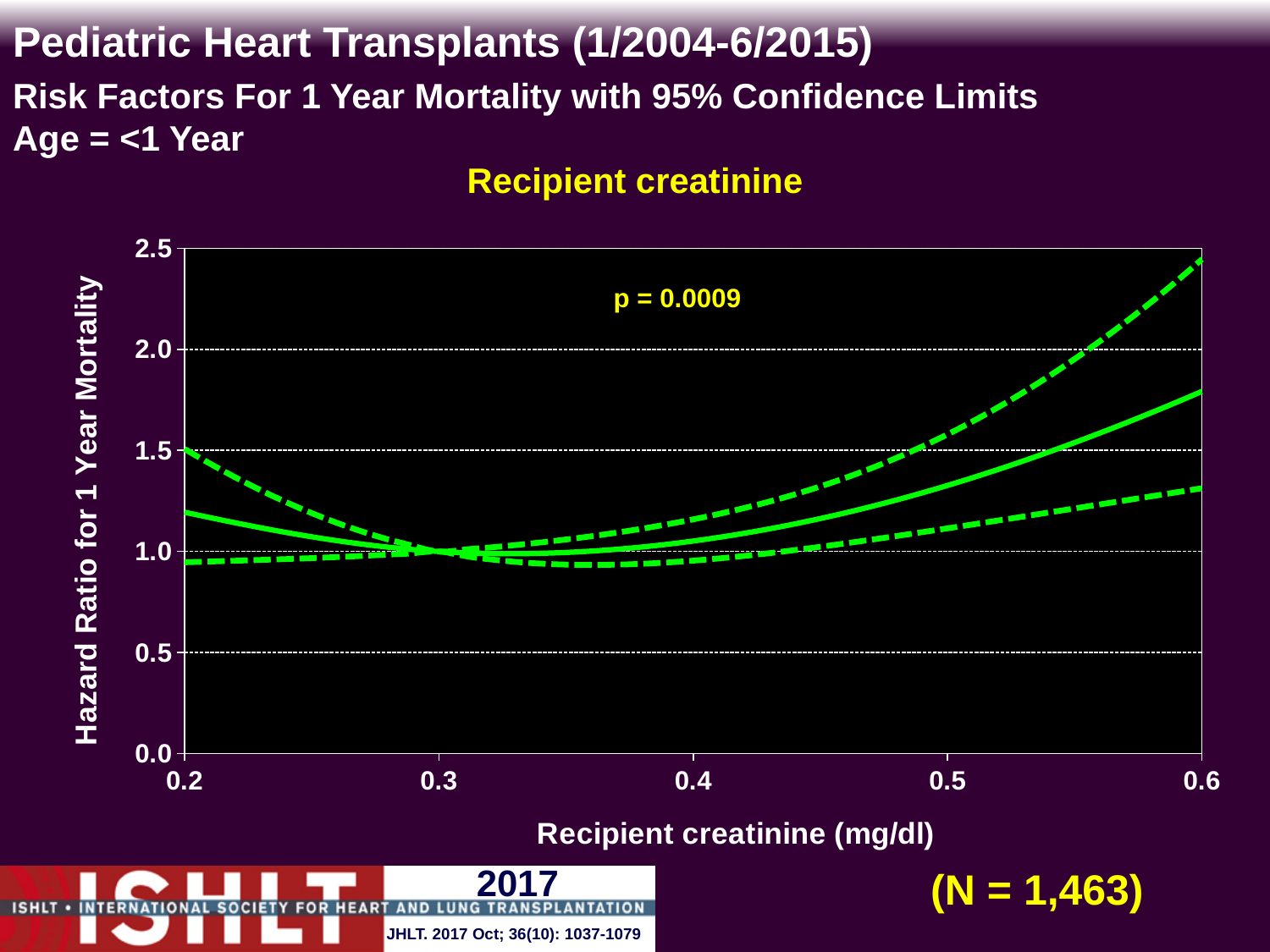
Is the solid hazard ratio line at a recipient creatinine of 0.6 mg/dl greater or less than 1.5? greater Is the solid hazard ratio line at a recipient creatinine of 0.2 mg/dl greater or less than 1.0? greater Is the upper dashed confidence limit at a recipient creatinine of 0.6 mg/dl greater or less than 2.0? greater What p-value is printed on the chart? p = 0.0009 What kind of chart is shown on the slide? line chart How many lines are plotted on the chart? 3 Is the solid hazard ratio line higher at a recipient creatinine of 0.6 mg/dl or at 0.2 mg/dl? 0.6 mg/dl What is the label of the y axis? Hazard Ratio for 1 Year Mortality Does the solid hazard ratio line rise or fall as recipient creatinine increases from 0.3 to 0.6 mg/dl? rise